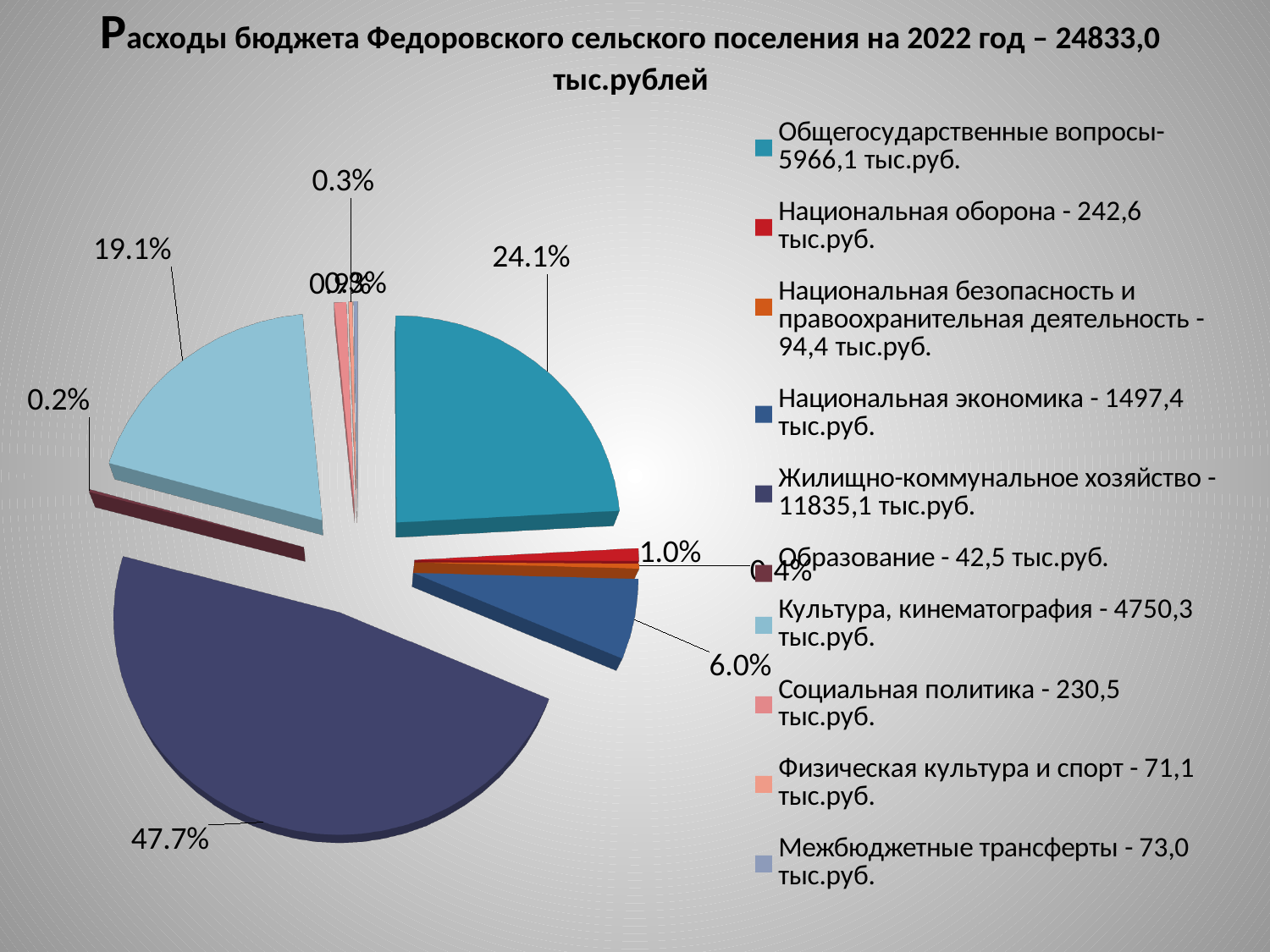
Which category has the largest slice of the pie? Жилищно-коммунальное хозяйство What is the difference between the amounts for Общегосударственные вопросы (5966,1) and Культура, кинематография (4750,3) in тыс.руб.? 1215,8 What share of the pie is labelled for Национальная экономика? 6.0% What kind of chart is shown on the slide? pie chart What share of the pie is labelled for Общегосударственные вопросы? 24.1% How many categories does the legend of the pie chart list? 10 According to the legend, what is the amount for Культура, кинематография? 4750,3 тыс.руб. What total budget expenditure is stated in the chart title? 24833,0 тыс.рублей What share of the pie is labelled for Жилищно-коммунальное хозяйство? 47.7% According to the legend, what is the amount for Национальная оборона? 242,6 тыс.руб. Which category has the smallest amount in the legend? Образование Which is larger: Общегосударственные вопросы or Культура, кинематография? Общегосударственные вопросы